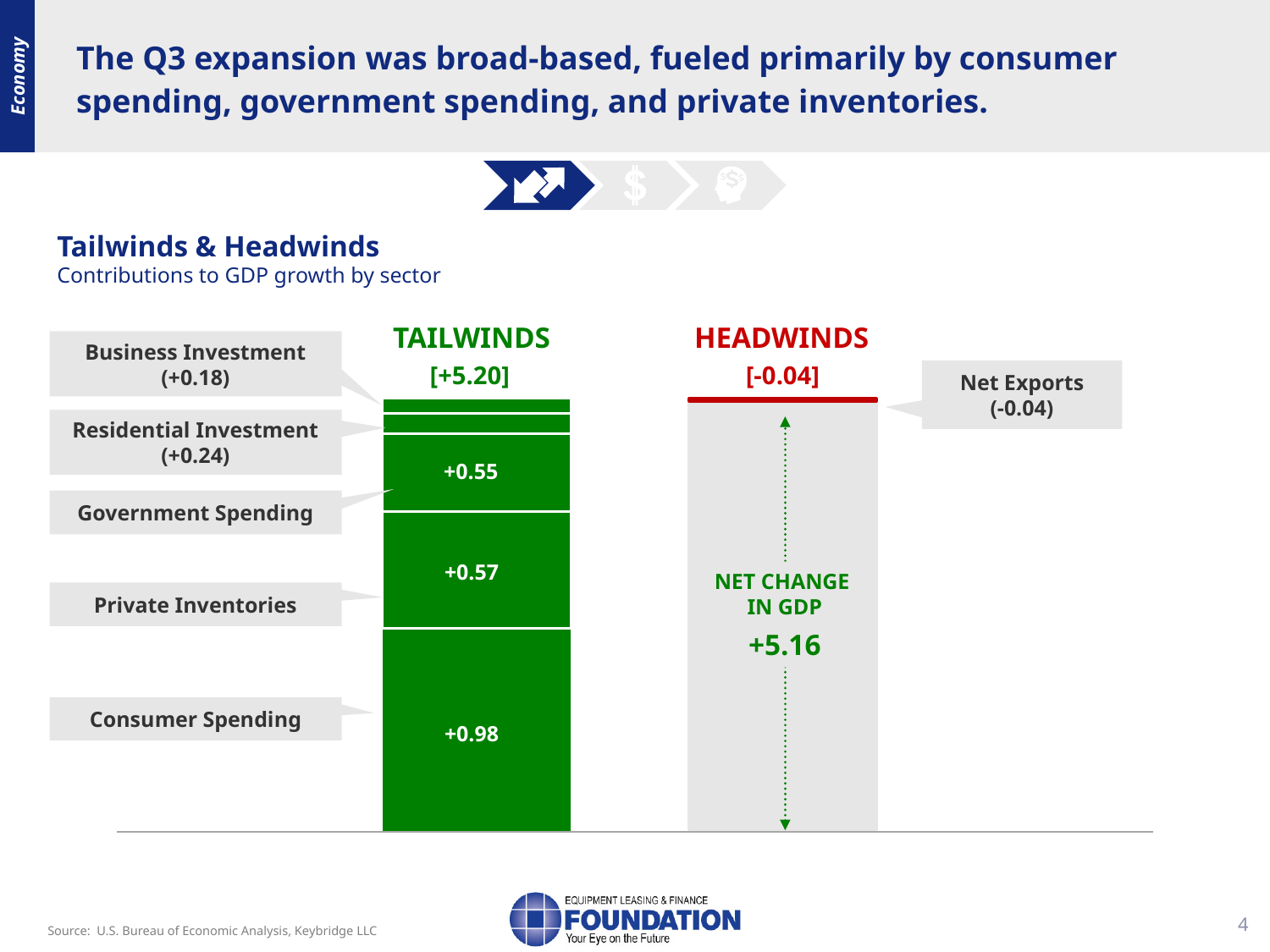
What is the subtitle of the chart under 'Tailwinds & Headwinds'? Contributions to GDP growth by sector Which tailwind sector has the smallest contribution to GDP growth on the chart? Business Investment What is the total value shown for the Tailwinds bar? +5.20 What is the difference between the contributions of Consumer Spending and Private Inventories? 0.41 Which sector has the largest contribution to GDP growth on the chart? Consumer Spending How many sectors are listed as tailwinds on the chart? 5 What is the contribution of Net Exports shown on the chart? -0.04 What is the contribution of Consumer Spending to GDP growth shown on the chart? +0.98 What is the contribution of Government Spending to GDP growth shown on the chart? +0.55 What is the net change in GDP shown on the chart? +5.16 What is the contribution of Private Inventories to GDP growth shown on the chart? +0.57 What is the contribution of Residential Investment shown on the chart? +0.24